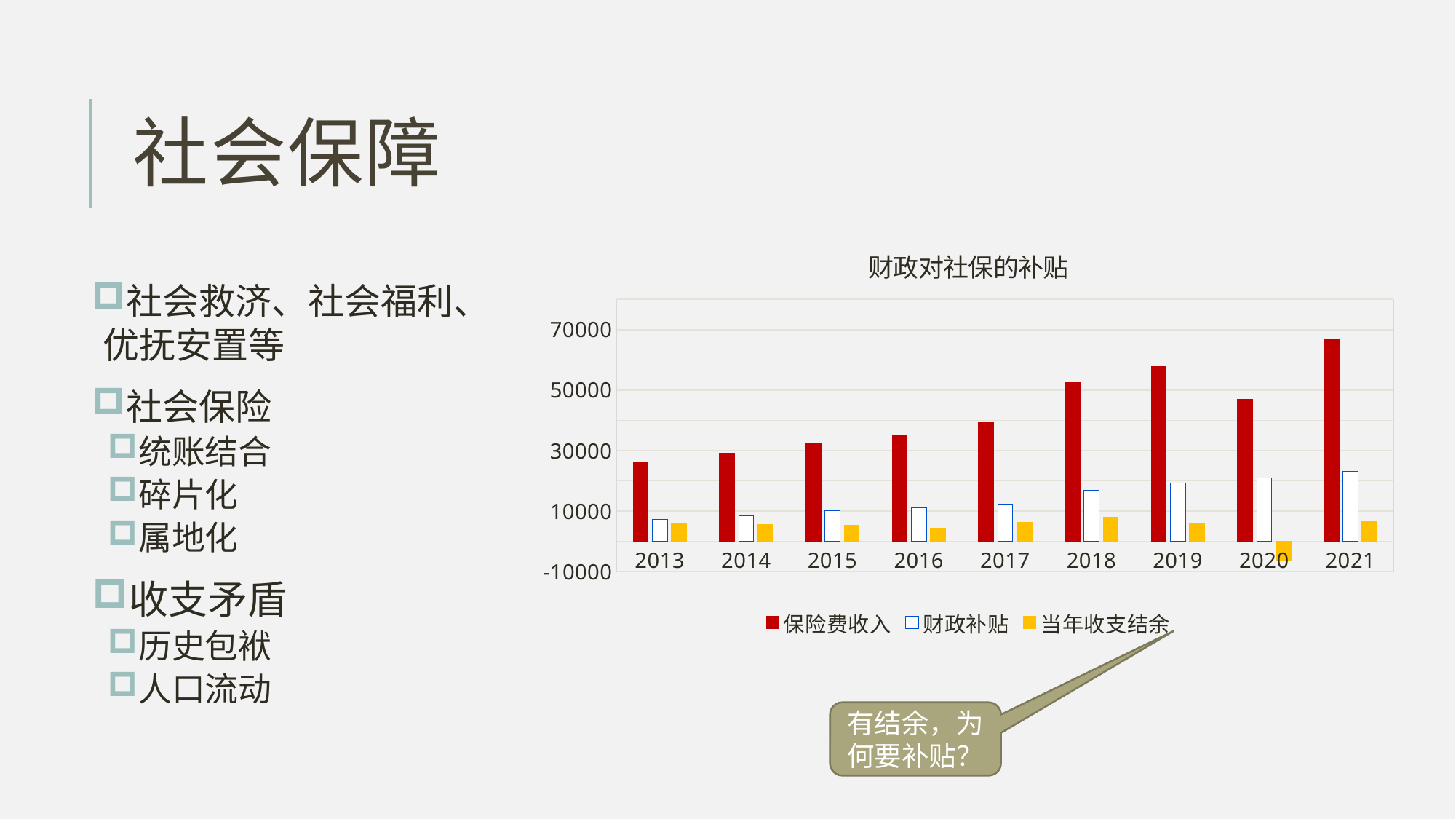
How many series does the legend list? 3 How many years are shown on the x axis? 9 What kind of chart is shown on the slide? bar chart What is the title of the chart? 财政对社保的补贴 Does the value for 财政补贴 rise or fall from 2013 to 2021? rise Is the value for 财政补贴 in 2013 greater or less than 10000? less Which is larger, 保险费收入 in 2019 or 保险费收入 in 2020? 2019 Which year has the lowest value for 当年收支结余? 2020 Is the value for 保险费收入 in 2021 greater or less than 50000? greater Which year has the highest value for 保险费收入? 2021 Which year has the highest value for 财政补贴? 2021 Which year has the lowest value for 保险费收入? 2013